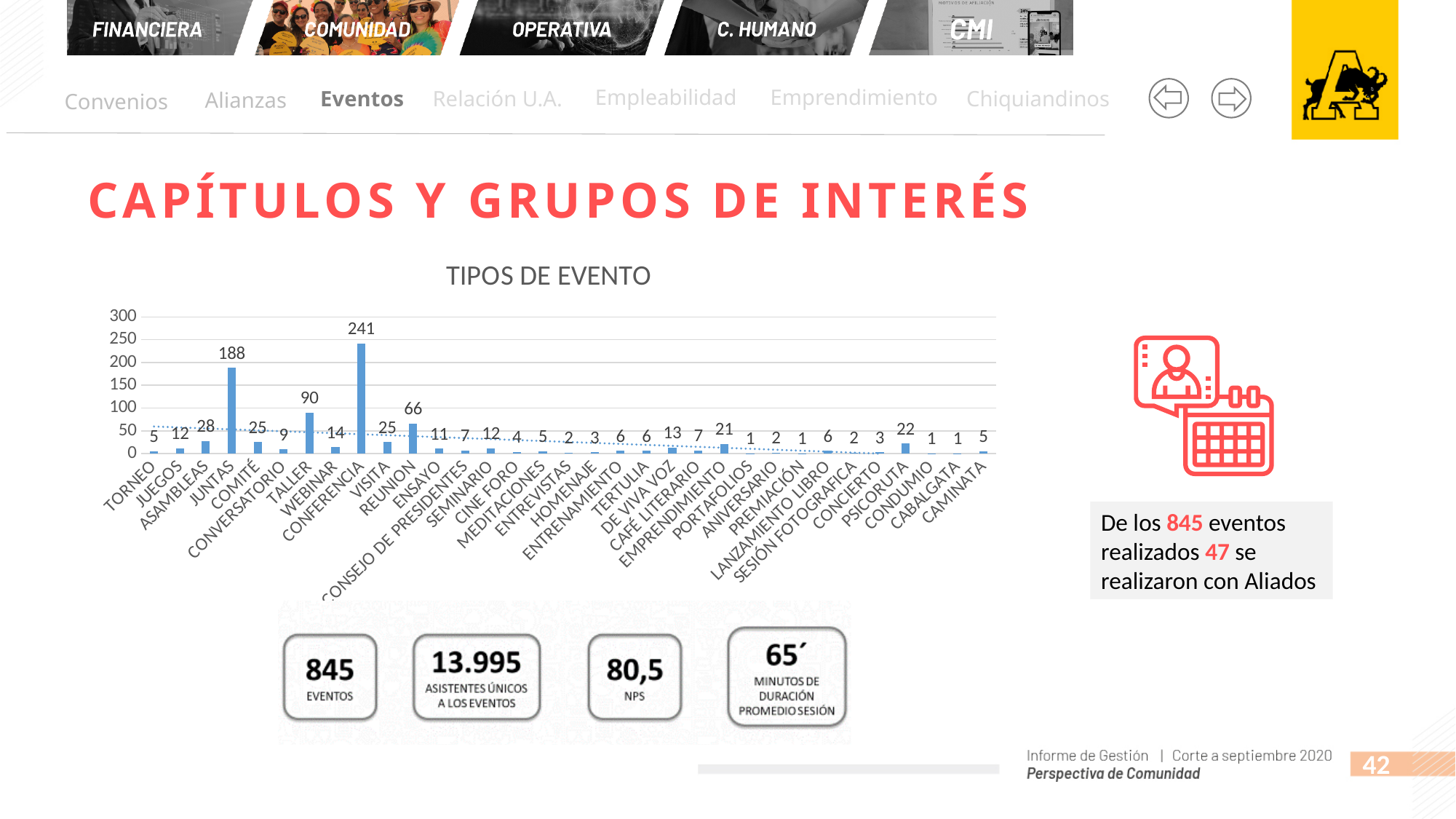
How many event types are shown on the x axis of the chart? 33 What is the value for PSICORUTA? 22 What is the value for REUNION? 66 Which event type has the highest value in the chart? CONFERENCIA Does the dotted trend line in the chart rise or fall from left to right? Fall What is the value for TALLER? 90 What is the title of the chart? TIPOS DE EVENTO Which is larger, the value for TALLER or the value for REUNION? TALLER What is the difference between the values for CONFERENCIA and JUNTAS? 53 What is the value for JUNTAS? 188 What type of chart is used to show TIPOS DE EVENTO? Bar chart Is the value for CONFERENCIA greater or less than 200? greater